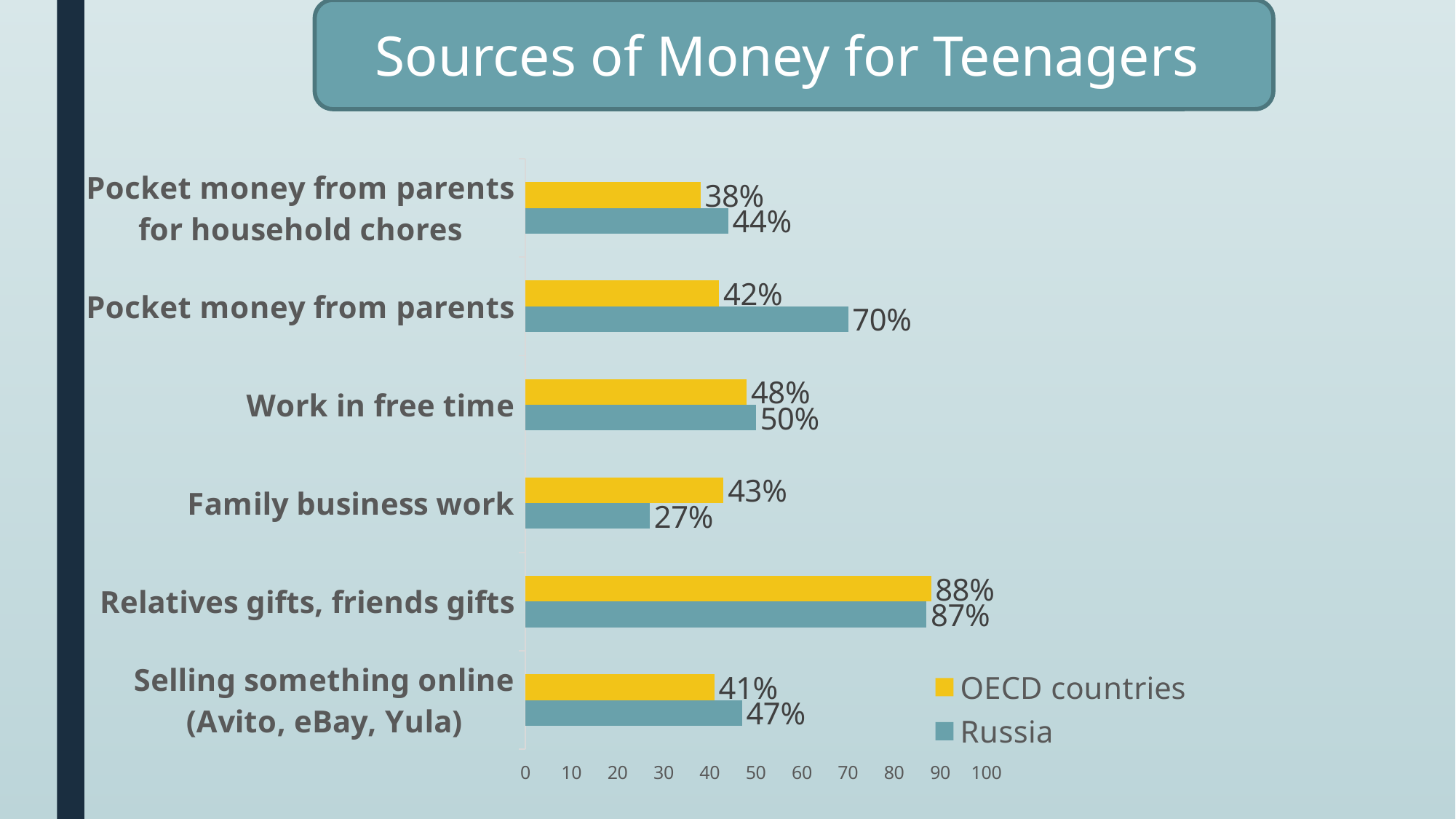
Which is larger for "Family business work": the OECD countries value or the Russia value? OECD countries Which category has the lowest value for Russia? Family business work Which colour represents Russia in the chart? Teal (blue-green) What is the value for OECD countries for "Family business work"? 43% What is the difference between the Russia and OECD countries values for "Pocket money from parents"? 28% What is the title of the chart? Sources of Money for Teenagers What is the value for Russia for "Pocket money from parents"? 70% What is the value for Russia for "Selling something online (Avito, eBay, Yula)"? 47% Which category has the highest value for OECD countries? Relatives gifts, friends gifts How many series does the legend list? 2 What kind of chart is shown on the slide? Bar chart How many categories are shown on the chart? 6